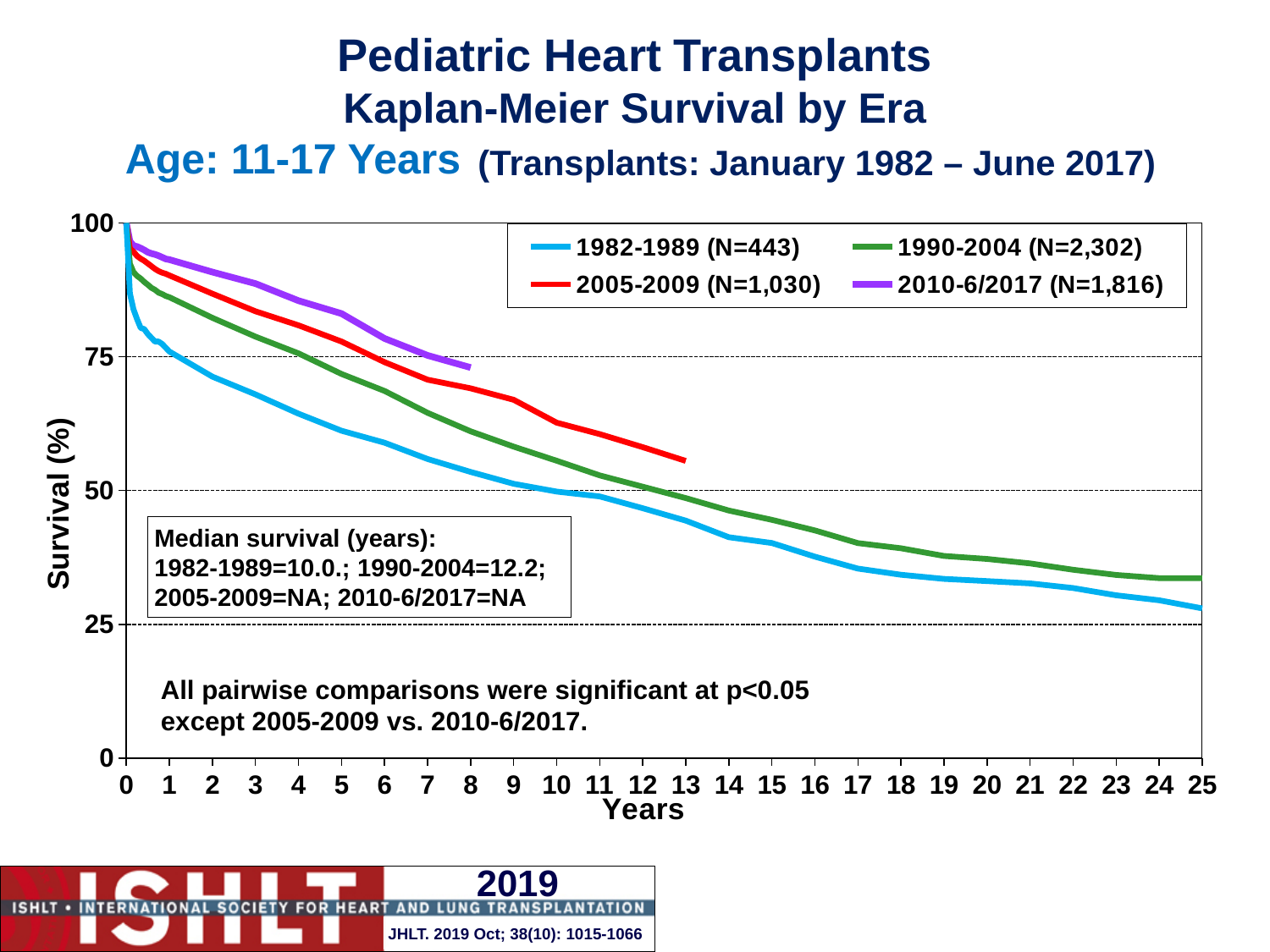
Which era has the lowest survival at 5 years? 1982-1989 Which era has the highest survival at 5 years? 2010-6/2017 Do the survival curves rise or fall as years since transplant increase? Fall Is the survival for the 2005-2009 era at 13 years greater or less than 50? greater What is the N for the 2005-2009 era shown in the legend? N=1,030 How many series (eras) does the legend list? 4 What kind of chart is shown on the slide? Line chart Which pairwise comparison of eras was not significant at p<0.05? 2005-2009 vs. 2010-6/2017 What is the N for the 2010-6/2017 era shown in the legend? N=1,816 What is the median survival in years for the 1990-2004 era? 12.2 Is the survival for the 1982-1989 era at 25 years greater or less than 50? less What is the median survival in years for the 1982-1989 era? 10.0